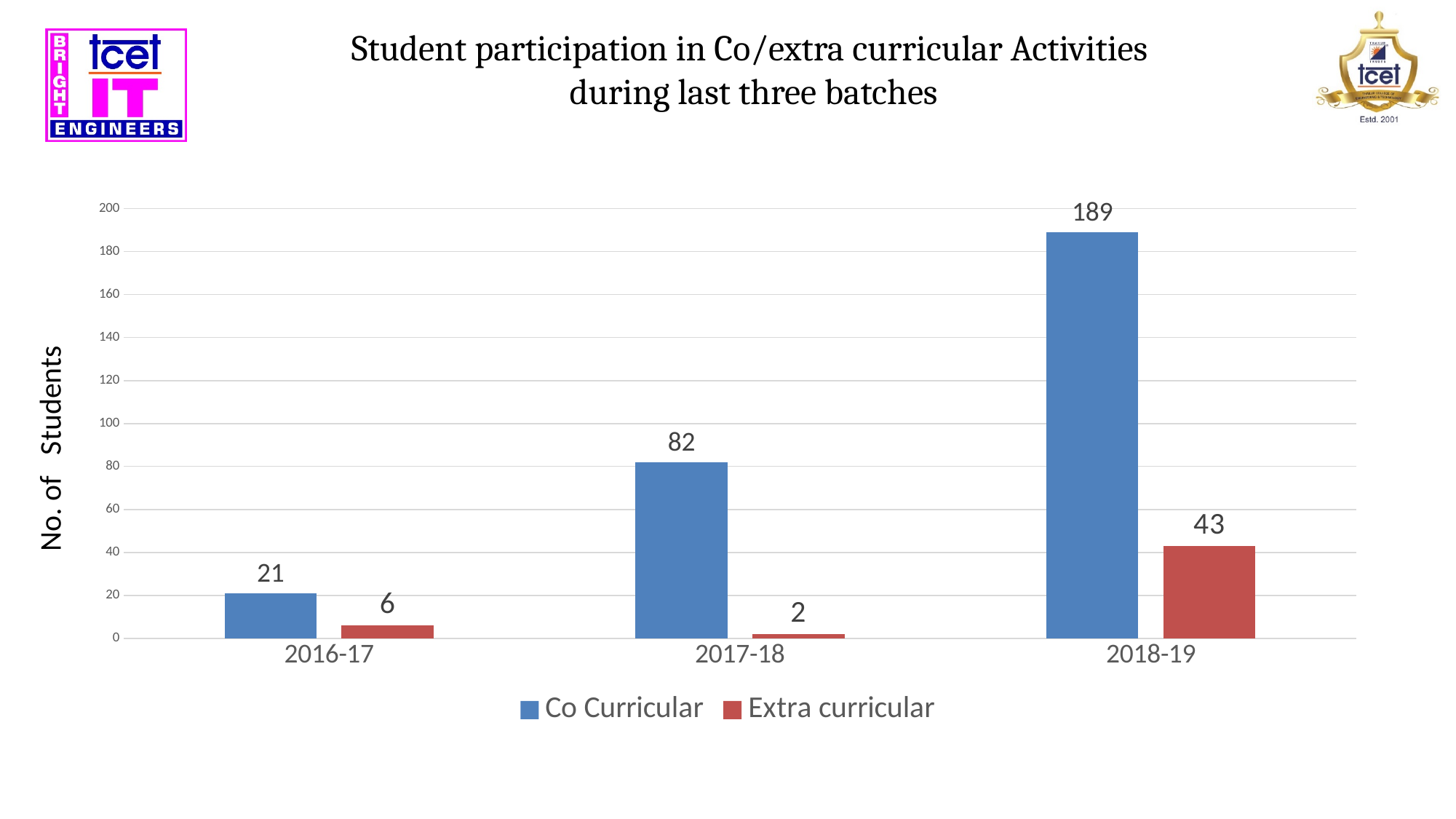
How many batches are shown on the x axis? 3 What is the difference between the Co Curricular values for 2018-19 and 2017-18? 107 What kind of chart is shown on the slide? Bar chart What is the Co Curricular value for 2018-19? 189 Which batch has the lowest Co Curricular value? 2016-17 Which batch has the highest Extra curricular value? 2018-19 Do the Co Curricular values rise or fall from 2016-17 to 2018-19? Rise How many series does the legend list? 2 Which is larger: the Extra curricular value for 2016-17 or for 2017-18? 2016-17 What is the label of the y axis? No. of Students What is the Extra curricular value for 2016-17? 6 What is the Co Curricular value for 2017-18? 82